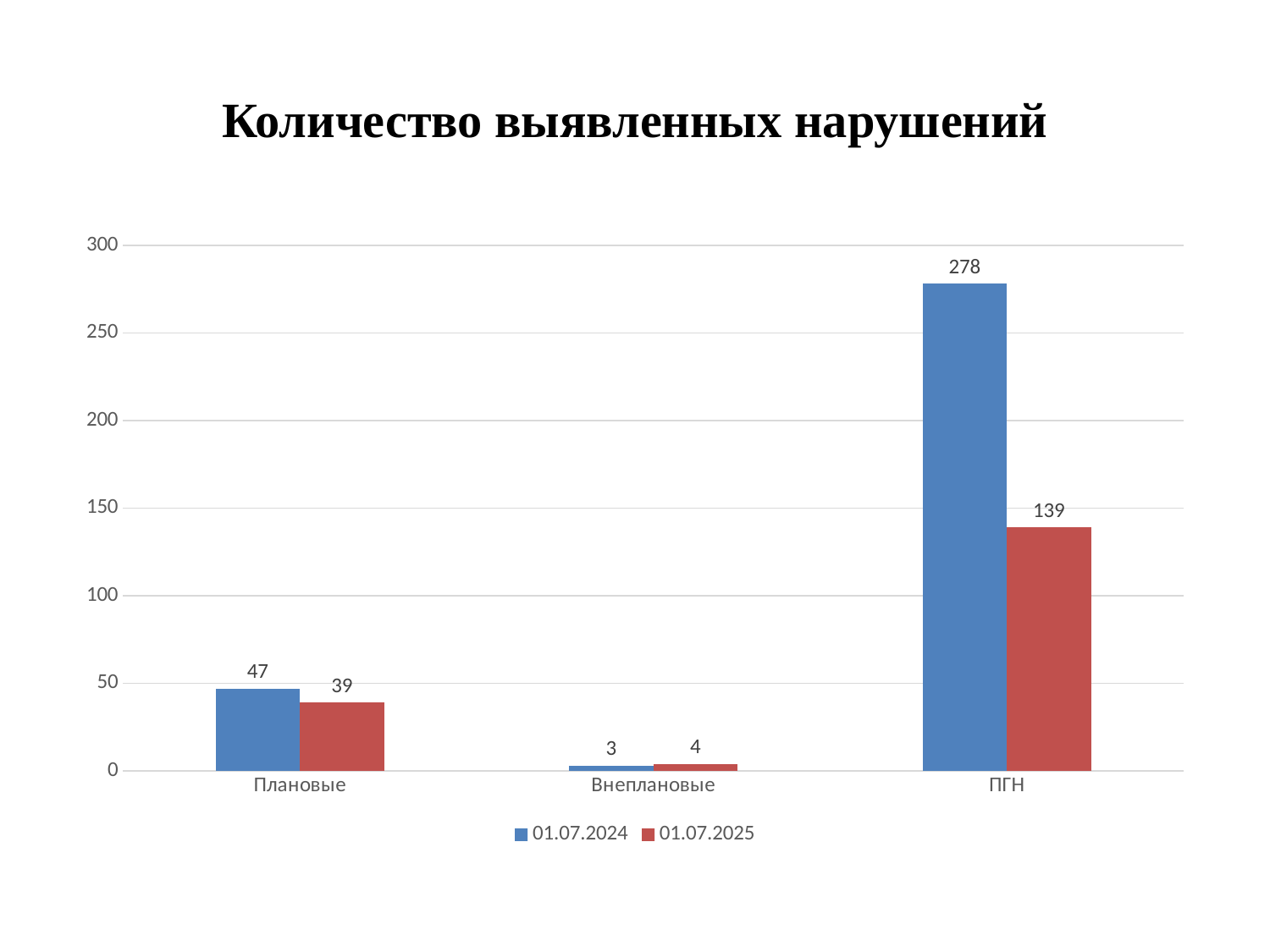
What is the value for Внеплановые in the 01.07.2024 series? 3 Is the 01.07.2025 value for ПГН greater or less than 100? greater How many categories are shown on the x axis? 3 What is the value for ПГН in the 01.07.2024 series? 278 Which category has the highest value in the 01.07.2025 series? ПГН Which category has the lowest value in the 01.07.2024 series? Внеплановые What is the difference between the 01.07.2024 and 01.07.2025 values for Плановые? 8 What is the value for Плановые in the 01.07.2025 series? 39 Which is larger for Внеплановые: the 01.07.2024 value or the 01.07.2025 value? 01.07.2025 What is the difference between the 01.07.2024 and 01.07.2025 values for ПГН? 139 How many series does the legend list? 2 What kind of chart is shown on the slide? bar chart